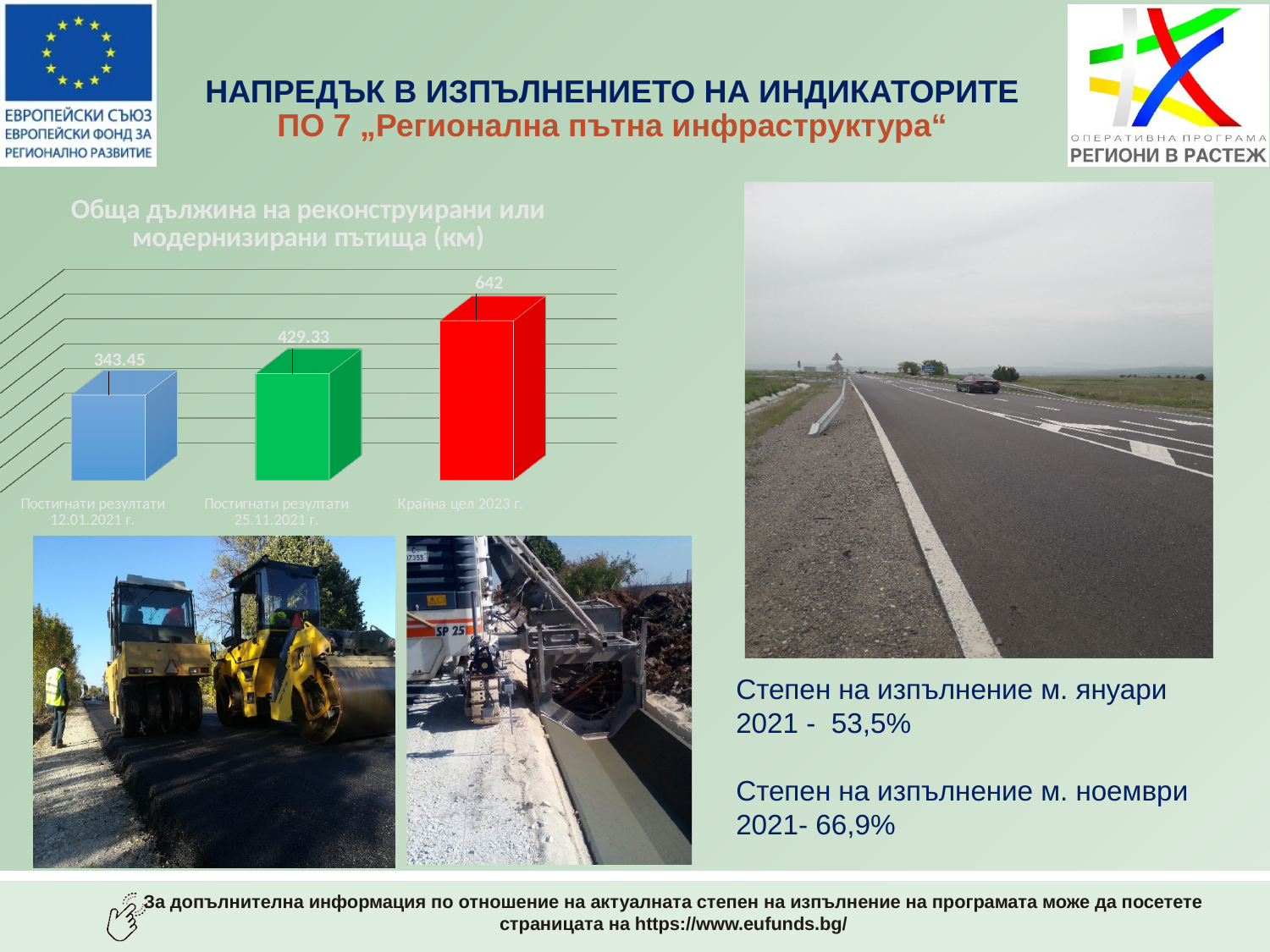
What is the value for "Постигнати резултати 25.11.2021 г." in the chart? 429.33 What kind of chart is shown on the slide? Bar chart What is the difference between the value for "Крайна цел 2023 г." and the value for "Постигнати резултати 25.11.2021 г."? 212.67 Which is larger: the value for "Постигнати резултати 25.11.2021 г." or the value for "Постигнати резултати 12.01.2021 г."? Постигнати резултати 25.11.2021 г. What is the value for "Крайна цел 2023 г." in the chart? 642 What is the difference between the value for "Постигнати резултати 25.11.2021 г." and the value for "Постигнати резултати 12.01.2021 г."? 85.88 Do the values rise or fall from left to right across the categories in the chart? Rise Which category has the highest value in the chart? Крайна цел 2023 г. How many categories are shown in the chart? 3 What is the title of the chart? Обща дължина на реконструирани или модернизирани пътища (км) What is the value for "Постигнати резултати 12.01.2021 г." in the chart? 343.45 Which category has the lowest value in the chart? Постигнати резултати 12.01.2021 г.